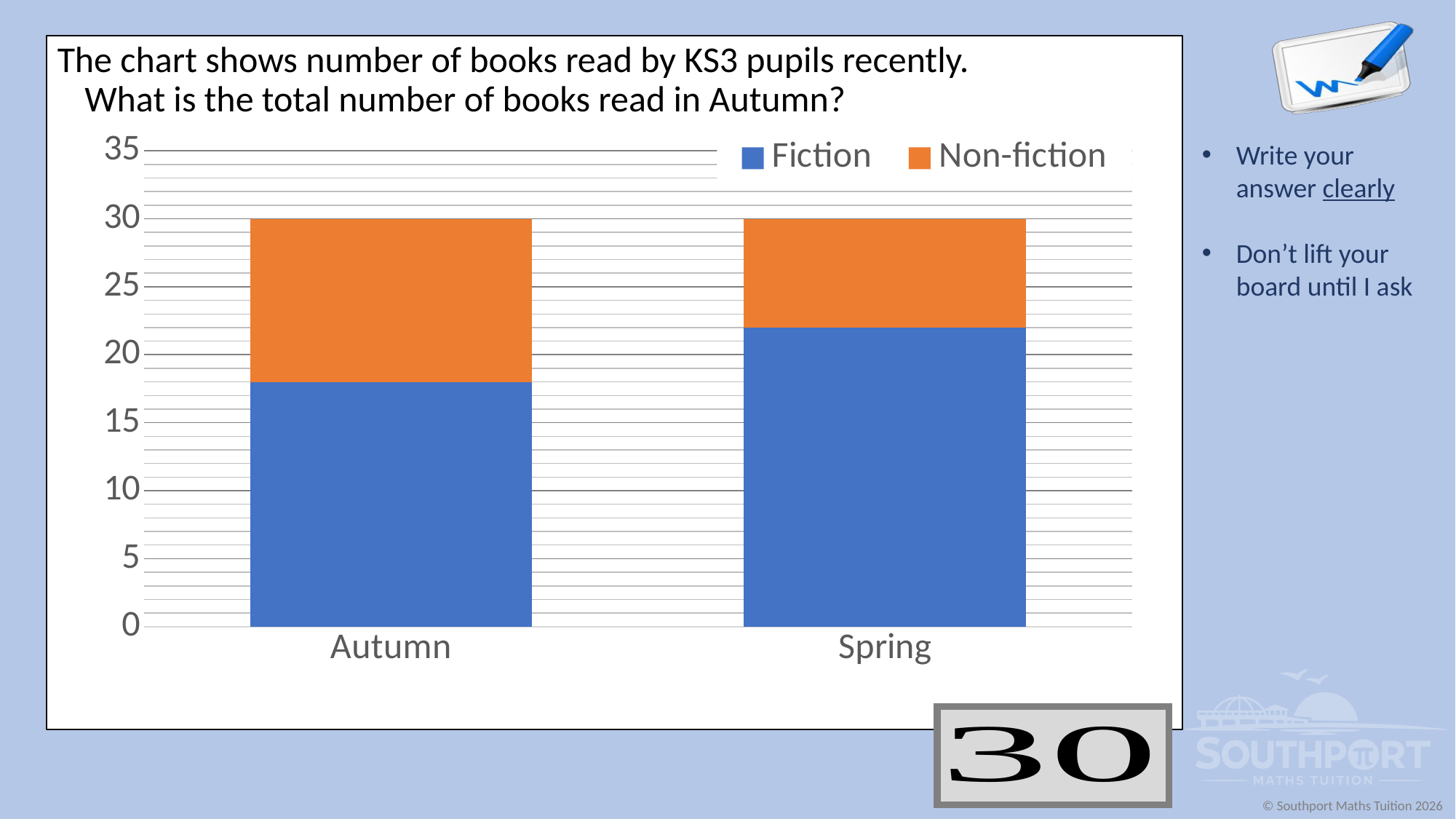
What is the total height of the stacked bar for Spring? 30 What is the total height of the stacked bar for Autumn? 30 How many categories are shown on the x axis of the chart? 2 Which term has the larger Fiction value, Autumn or Spring? Spring Is the Non-fiction value for Spring greater or less than 10? less Is the Fiction value for Spring greater or less than 20? greater Which colour represents Non-fiction in the chart? orange What kind of chart is shown on the slide? bar chart Is the Non-fiction value for Autumn greater or less than 10? greater How many series does the chart's legend list? 2 Which term has the larger Non-fiction value, Autumn or Spring? Autumn